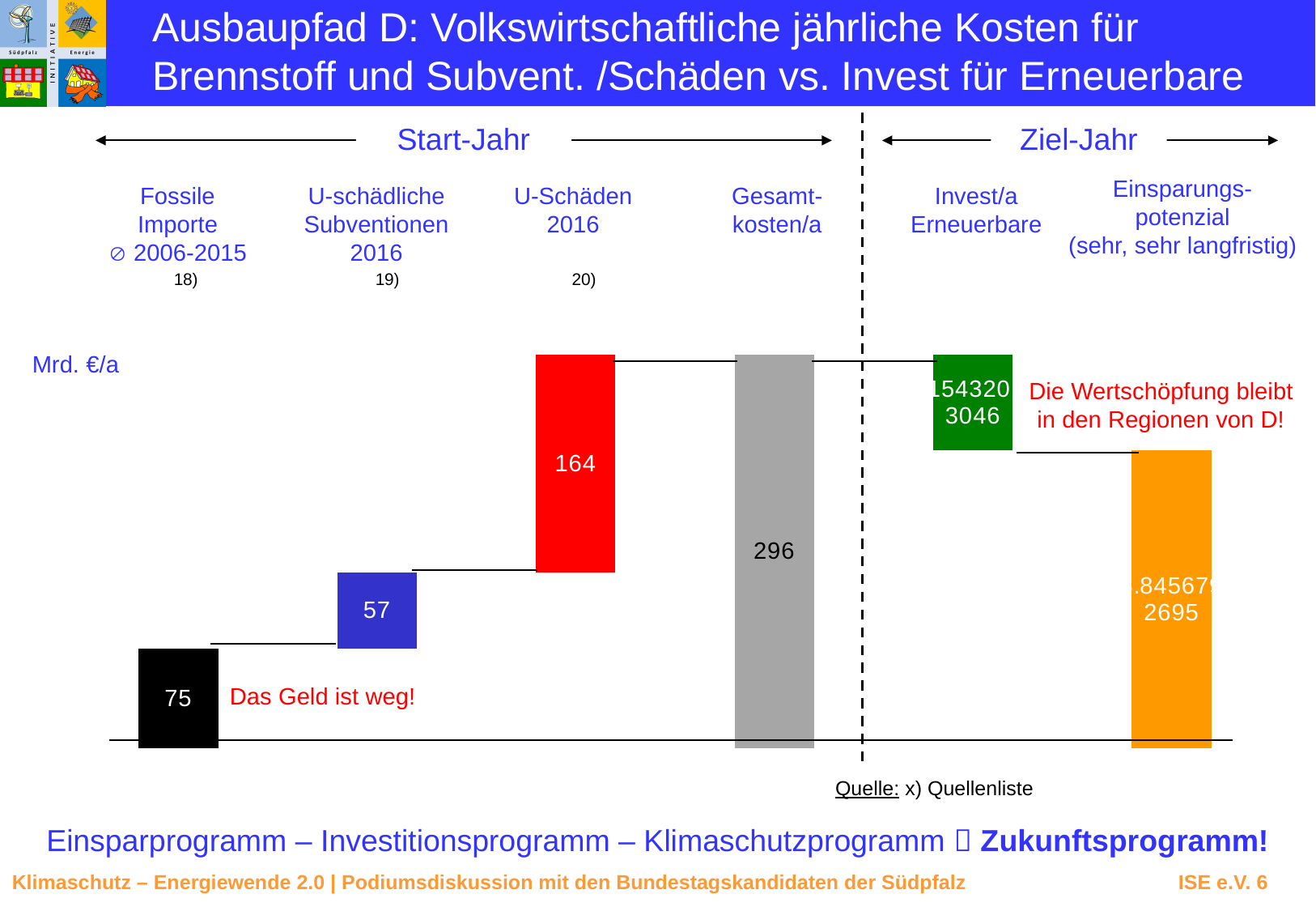
What unit is given for the values in the chart? Mrd. €/a What is the value shown for U-schädliche Subventionen 2016? 57 What is the value shown for Fossile Importe (⌀ 2006-2015)? 75 What is the value shown for Gesamtkosten/a? 296 What kind of chart is shown on the slide? Bar chart Which of the three Start-Jahr cost components (Fossile Importe, U-schädliche Subventionen, U-Schäden) has the highest value? U-Schäden 2016 Which is larger, the value for U-Schäden 2016 or the value for U-schädliche Subventionen 2016? U-Schäden 2016 What is the sum of the values for Fossile Importe, U-schädliche Subventionen 2016 and U-Schäden 2016? 296 Which of the three Start-Jahr cost components (Fossile Importe, U-schädliche Subventionen, U-Schäden) has the lowest value? U-schädliche Subventionen 2016 What is the value shown for U-Schäden 2016? 164 What is the difference between the value for U-Schäden 2016 and the value for Fossile Importe? 89 What is the difference between the value for Fossile Importe and the value for U-schädliche Subventionen 2016? 18